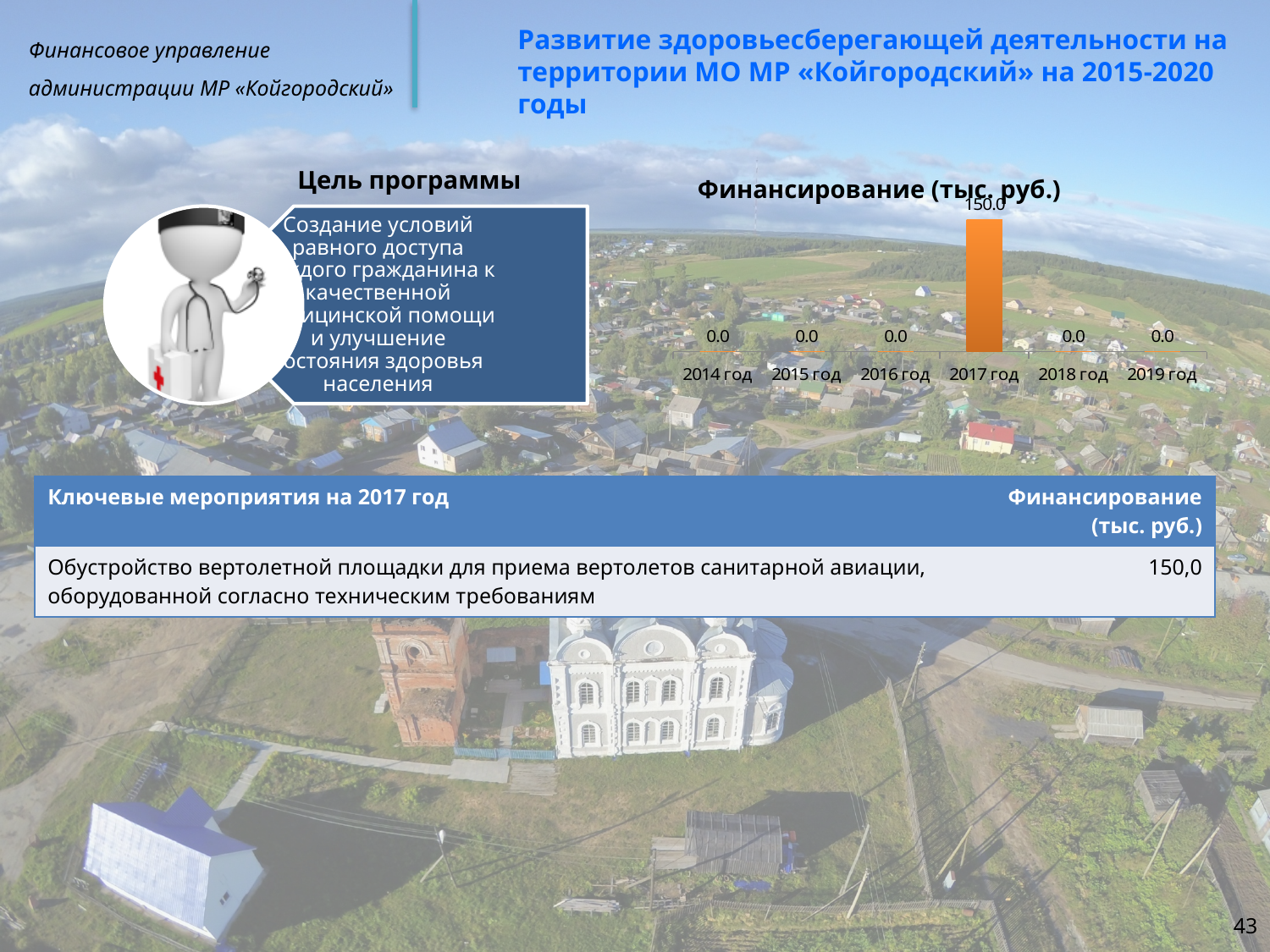
What is the value for 2017 год in the chart? 150.0 What is the difference between the values for 2017 год and 2016 год? 150.0 What is the value for 2015 год in the chart? 0.0 Which year has the highest value in the chart? 2017 год What is the value for 2014 год in the chart? 0.0 Which is larger, the value for 2017 год or the value for 2018 год? 2017 год What is the value for 2018 год in the chart? 0.0 What type of chart is shown under the title "Финансирование (тыс. руб.)"? bar chart How many years (categories) are shown on the x axis of the chart? 6 What is the value for 2019 год in the chart? 0.0 What colour is the bar for 2017 год? orange What is the title of the chart? Финансирование (тыс. руб.)